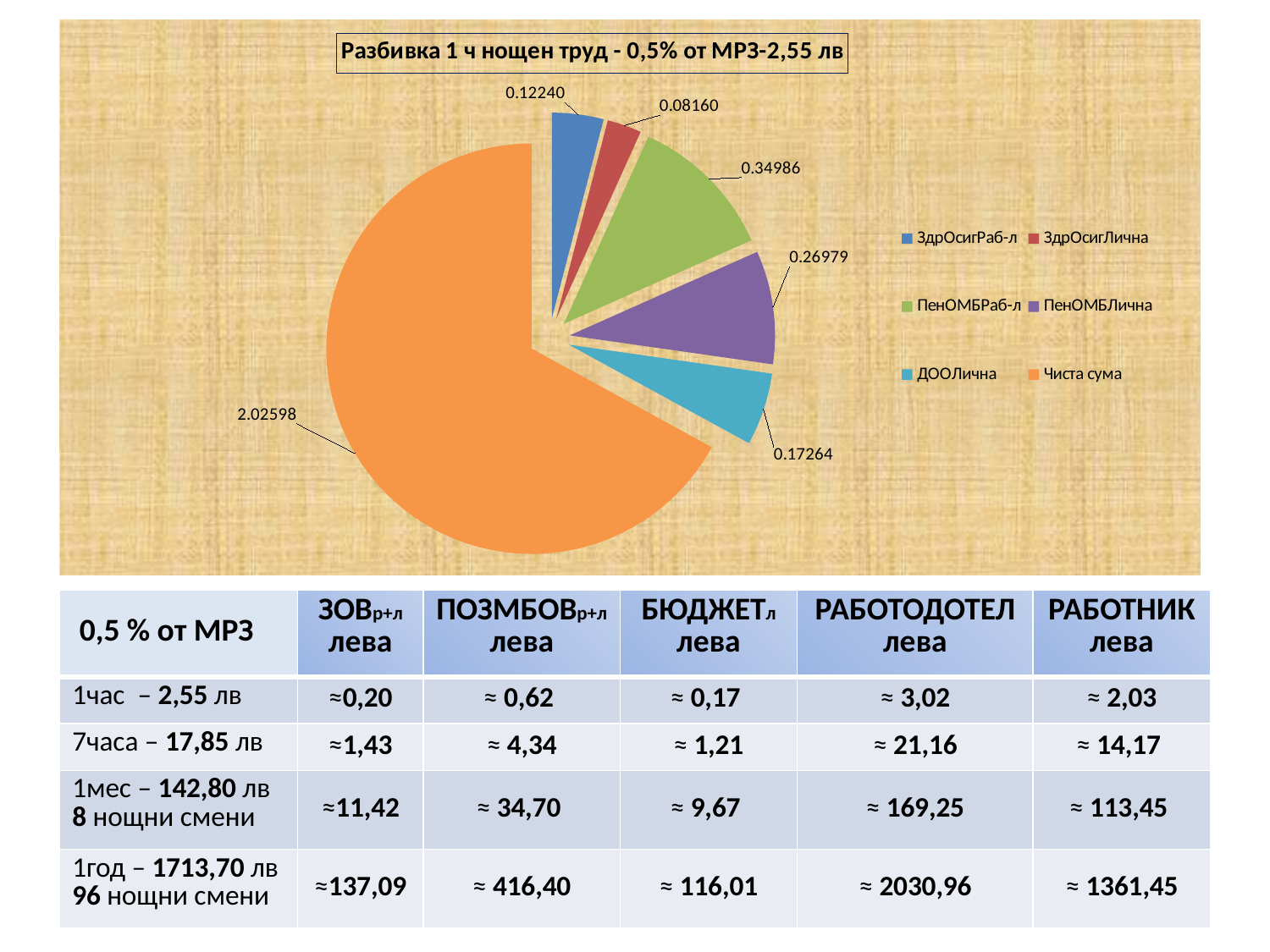
What is the value of the Чиста сума slice? 2.02598 What kind of chart is shown on the slide? pie chart What is the value of the ЗдрОсигЛична slice? 0.08160 What is the value of the ДООЛична slice? 0.17264 What is the value of the ПенОМБРаб-л slice? 0.34986 How many slices does the pie chart have? 6 Which slice of the pie is the largest? Чиста сума Which slice of the pie is the smallest? ЗдрОсигЛична Which is larger, ПенОМБРаб-л or ПенОМБЛична? ПенОМБРаб-л How many entries does the chart legend list? 6 What is the difference between the ЗдрОсигРаб-л and ЗдрОсигЛична values? 0.04080 What is the title of the chart? Разбивка 1 ч нощен труд - 0,5% от МРЗ-2,55 лв